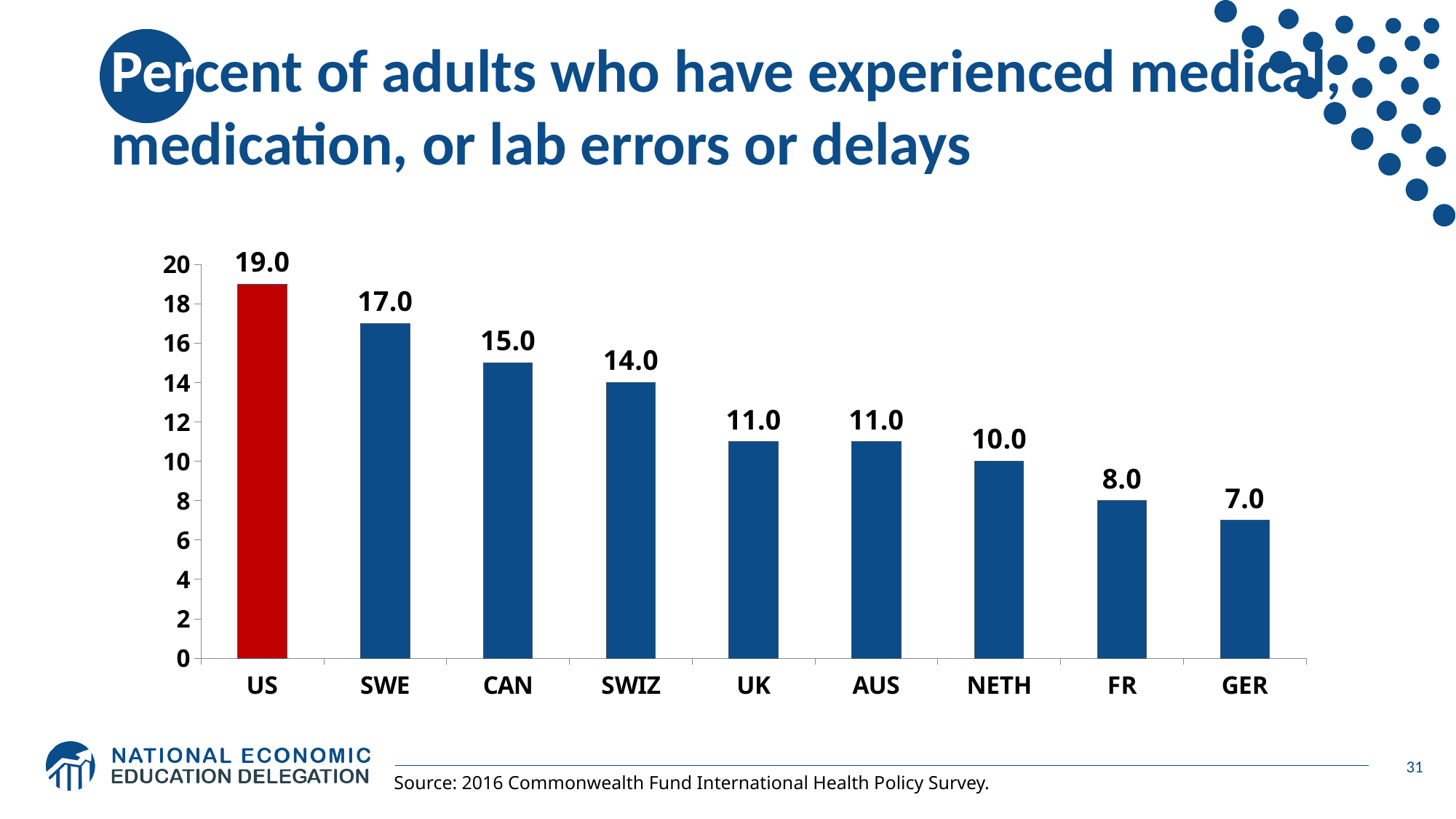
What is the value for the US? 19.0 What is the difference between the values for the US and SWE? 2.0 What kind of chart is shown on the slide? bar chart Which bar is coloured red rather than blue? US Which is larger, the value for FR or the value for NETH? NETH Which country has the lowest value? GER How many countries are shown on the chart? 9 What is the value for NETH? 10.0 Which country has the highest value? US Do the values rise or fall from left to right along the x axis? fall What is the value for SWIZ? 14.0 What is the difference between the values for CAN and GER? 8.0